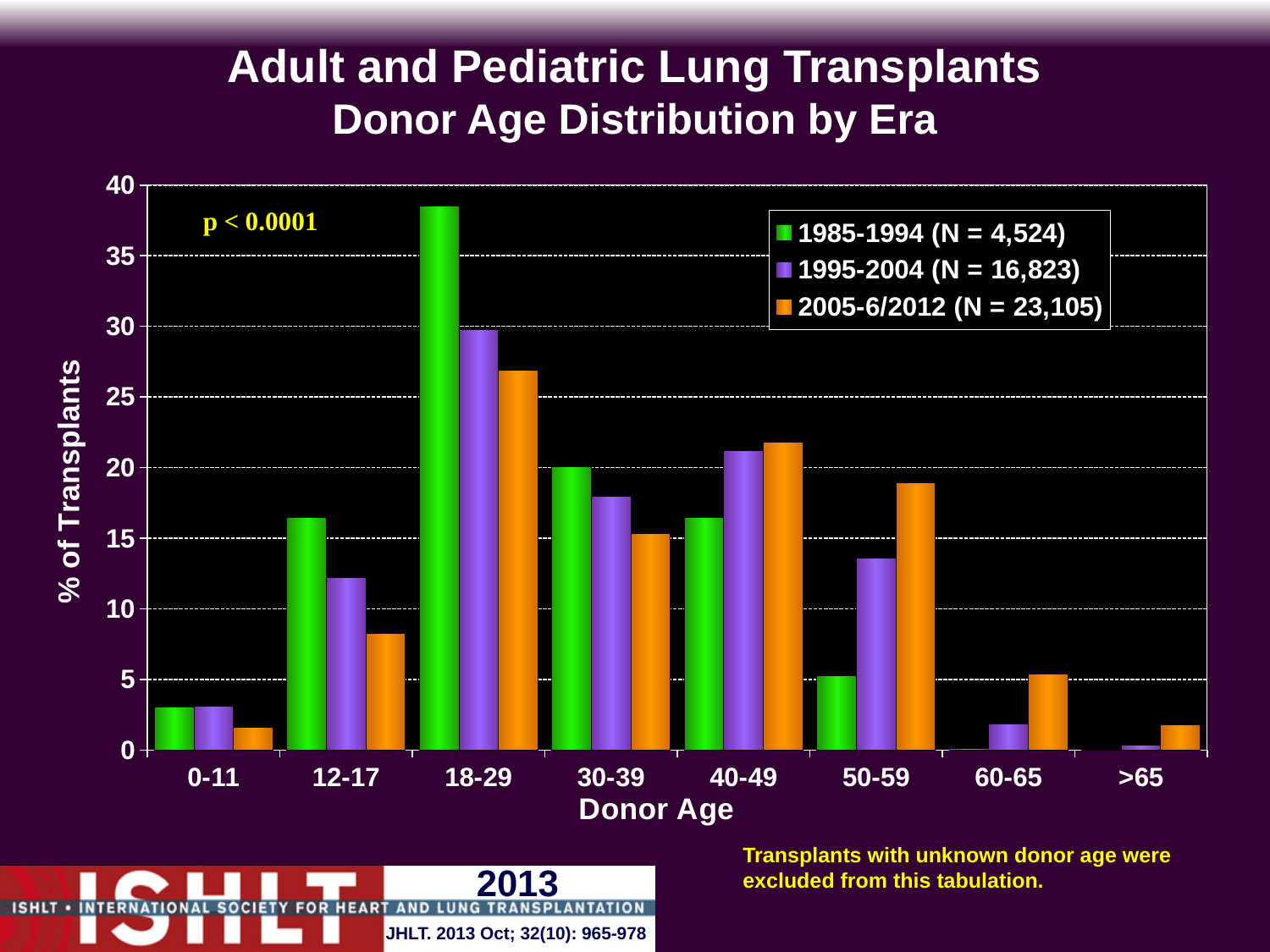
Which donor age group has the highest % of transplants for the 1985-1994 era? 18-29 Is the value for the 1995-2004 era in the 18-29 donor age group greater or less than 25? greater What is the N value shown in the legend for the 1995-2004 era? 16,823 In the 40-49 donor age group, which era has the larger % of transplants: 1985-1994 or 2005-6/2012? 2005-6/2012 Is the value for the 2005-6/2012 era in the 50-59 donor age group greater or less than 15? greater In the 12-17 donor age group, which era has the larger % of transplants: 1985-1994 or 1995-2004? 1985-1994 Which donor age group has the highest % of transplants for the 2005-6/2012 era? 18-29 Is the value for the 1985-1994 era in the 18-29 donor age group greater or less than 35? greater How many donor age groups are shown on the x axis? 8 What kind of chart is shown on the slide? Bar chart How many series does the legend list? 3